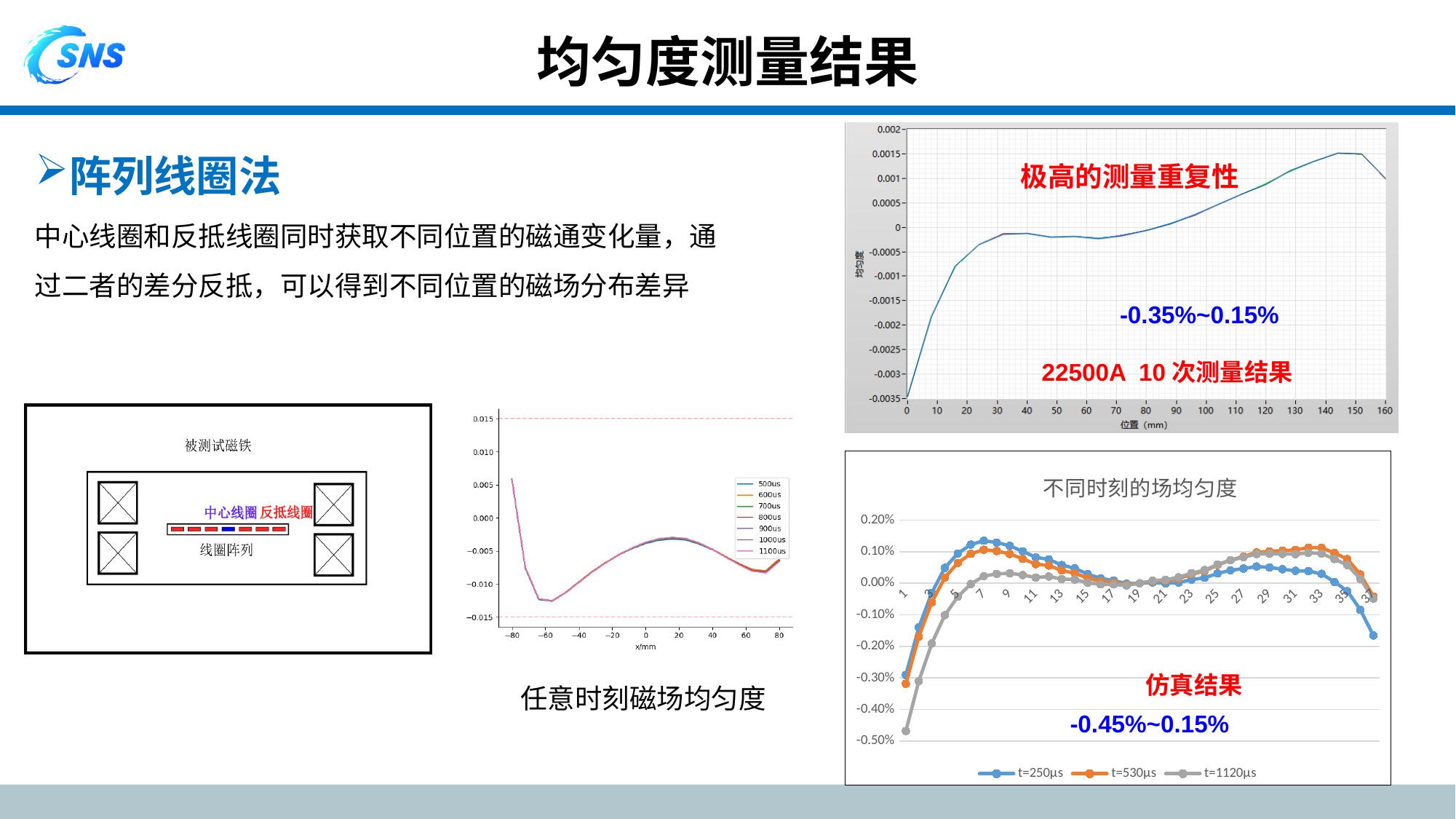
In the bottom-right chart (不同时刻的场均匀度), do the values of the t=250μs series rise or fall from x = 1 to x = 7? rise In the bottom-right chart (不同时刻的场均匀度), which series has the lowest value at x = 33? t=250μs In the top-right chart (22500A 10 次测量结果), is the value at position 0 mm greater or less than -0.003? less What is the x-axis label of the top-right chart (22500A 10 次测量结果)? 位置 (mm) How many series does the legend of the bottom-right chart (不同时刻的场均匀度) list? 3 In the bottom-right chart (不同时刻的场均匀度), which series has the lowest value at x = 1? t=1120μs What kind of chart is the bottom-right chart titled 不同时刻的场均匀度? line chart In the top-right chart (22500A 10 次测量结果), is the value at position 150 mm greater or less than 0.001? greater How many series does the legend of the middle chart (任意时刻磁场均匀度) list? 7 What is the x-axis label of the middle chart (任意时刻磁场均匀度)? x/mm In the bottom-right chart (不同时刻的场均匀度), is the value of the t=1120μs series at x = 1 greater or less than -0.40%? less